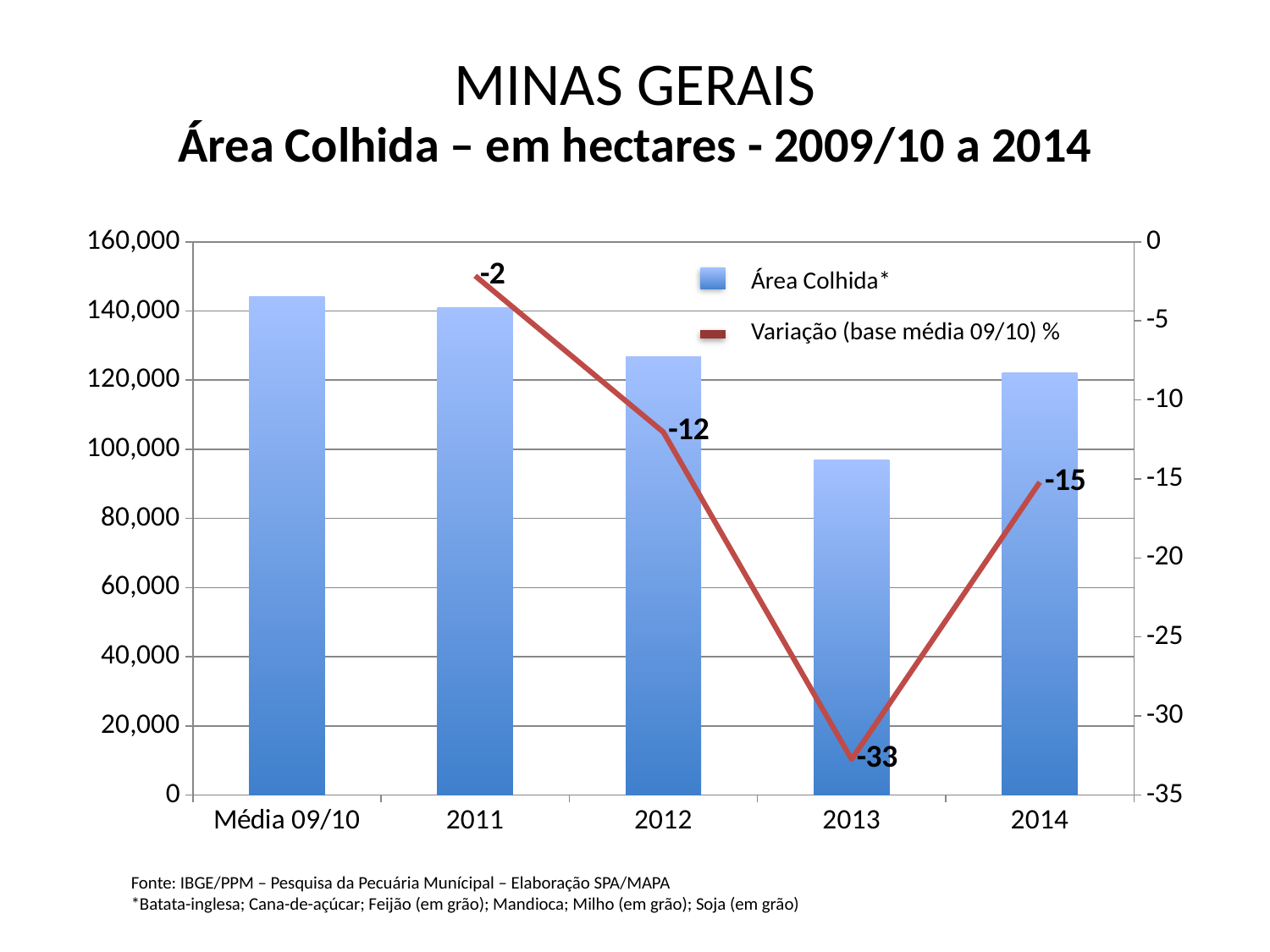
Which year has the larger Variação (base média 09/10) % value, 2012 or 2014? 2012 What is the value of Variação (base média 09/10) % for 2012? -12 Is the Área Colhida value for 2013 greater or less than 100,000? less How many categories are shown on the x axis? 5 What is the difference between the Variação values for 2012 and 2013? 21 What is the value of Variação (base média 09/10) % for 2013? -33 Which category has the lowest Área Colhida bar? 2013 Is the Área Colhida value for 2012 greater or less than 120,000? greater What is the value of Variação (base média 09/10) % for 2011? -2 How many series does the legend list? 2 What is the value of Variação (base média 09/10) % for 2014? -15 Which year has the lowest Variação (base média 09/10) % value? 2013